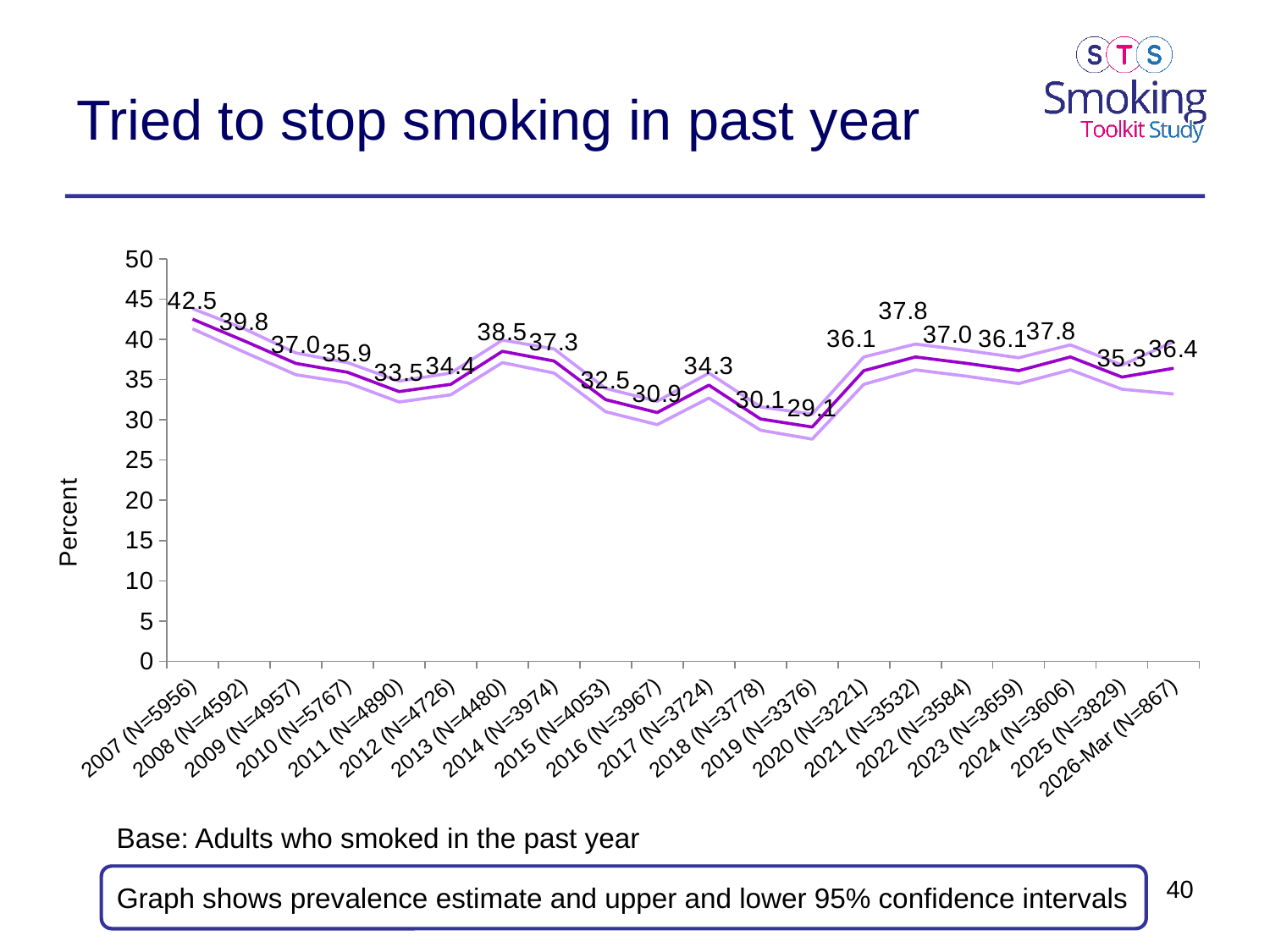
What is the label on the vertical axis of the chart? Percent What is the estimated percentage for 2026-Mar (N=867)? 36.4 Does the estimated percentage rise or fall from 2007 to 2011? Fall Which year has the highest estimated percentage of adults who tried to stop smoking? 2007 What is the difference between the estimated percentage in 2007 and in 2019? 13.4 Is the estimated percentage for 2018 greater or less than 35? less What is the estimated percentage of adults who tried to stop smoking in 2007? 42.5 Which year has a higher estimated percentage, 2013 or 2017? 2013 Which year has the lowest estimated percentage of adults who tried to stop smoking? 2019 What kind of chart is shown on the slide? Line chart What is the estimated percentage for 2019 (N=3376)? 29.1 How many time points are plotted on the chart? 20